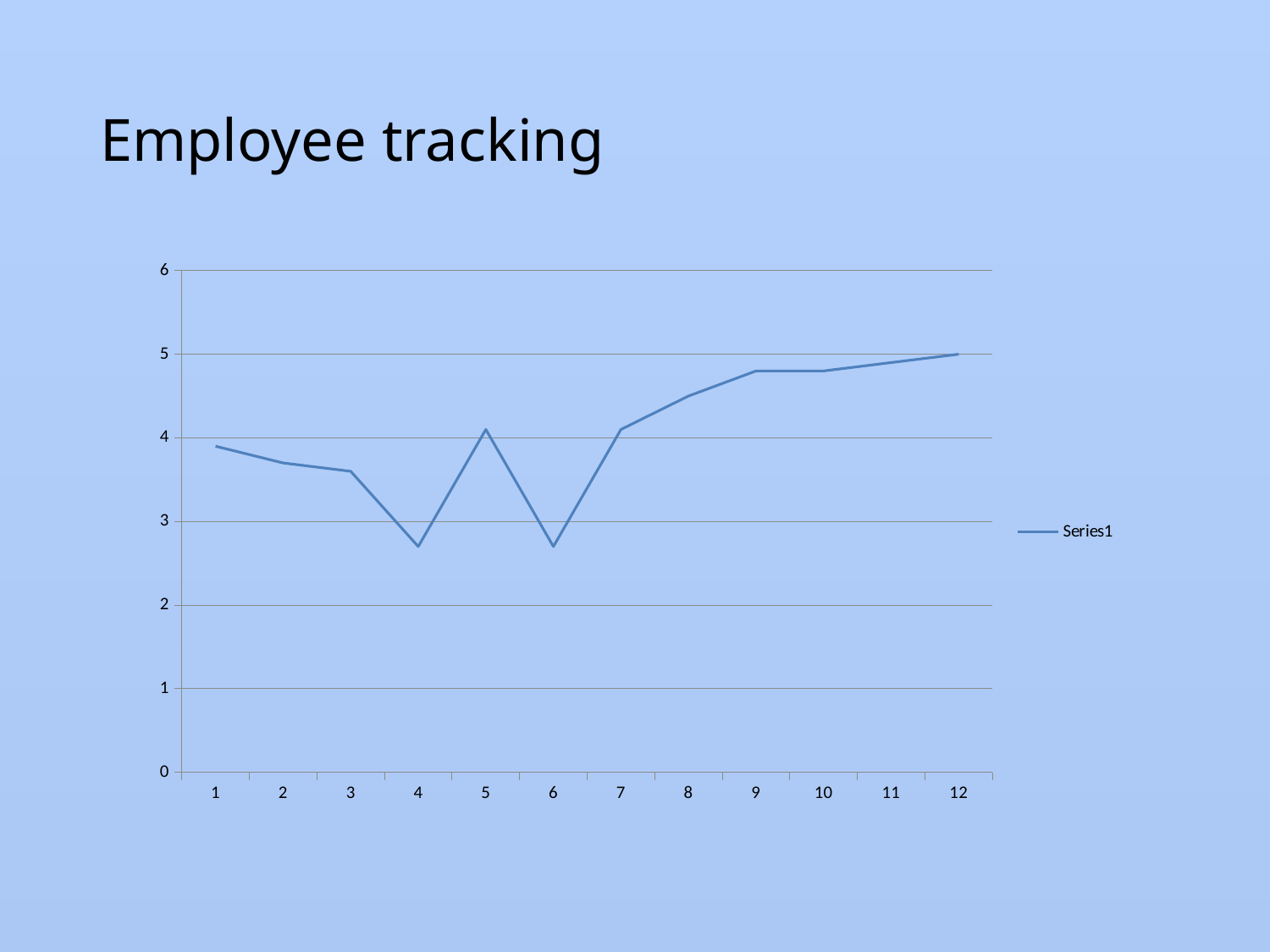
Which has the larger value, point 3 or point 7? point 7 Is the value at point 4 greater or less than 3? less What is the value at point 12? 5 Is the value at point 9 greater or less than 4? greater How many points are plotted along the x axis? 12 At which x-axis point does the line reach its highest value? 12 What kind of chart is shown on the slide? line chart What is the title of the slide containing the chart? Employee tracking How many series does the legend list? 1 Do the values rise or fall from point 7 to point 12? rise What is the name of the series shown in the legend? Series1